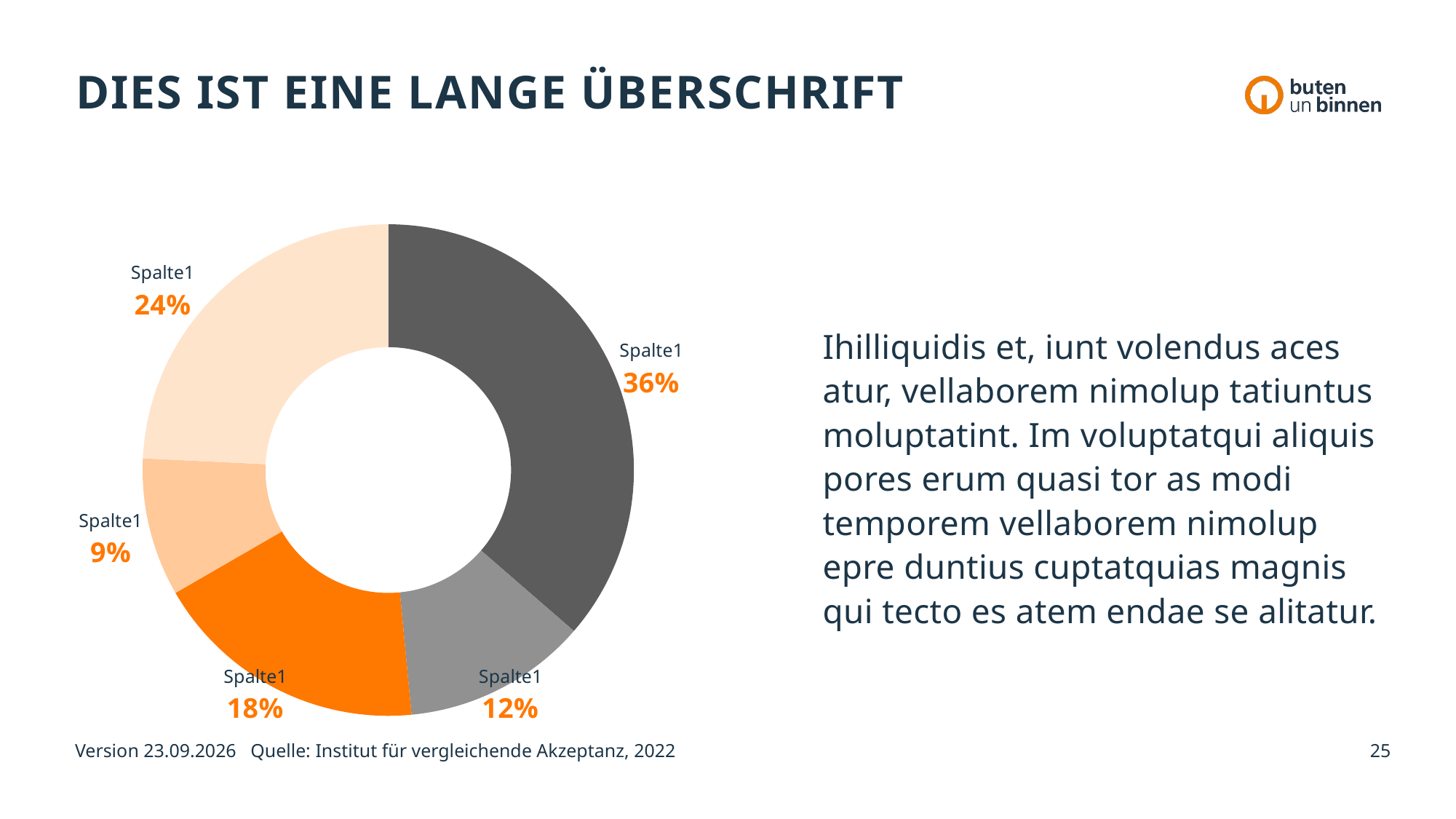
Which slice is larger: the bright orange slice or the light orange slice on the left? the bright orange slice (18%) What kind of chart is shown on the slide? doughnut (pie) chart What percentage is shown for the dark grey slice on the right side of the chart? 36% What percentage is shown for the pale peach slice at the top left of the chart? 24% What is the value of the largest slice in the chart? 36% What is the value of the smallest slice in the chart? 9% What is the difference in percentage points between the largest slice (36%) and the medium grey slice (12%)? 24 percentage points What source is cited for the chart at the bottom of the slide? Institut für vergleichende Akzeptanz, 2022 What percentage is shown for the medium grey slice at the bottom right of the chart? 12% What label text is shown for every slice of the chart? Spalte1 How many slices does the chart have? 5 What percentage is shown for the bright orange slice at the bottom left of the chart? 18%